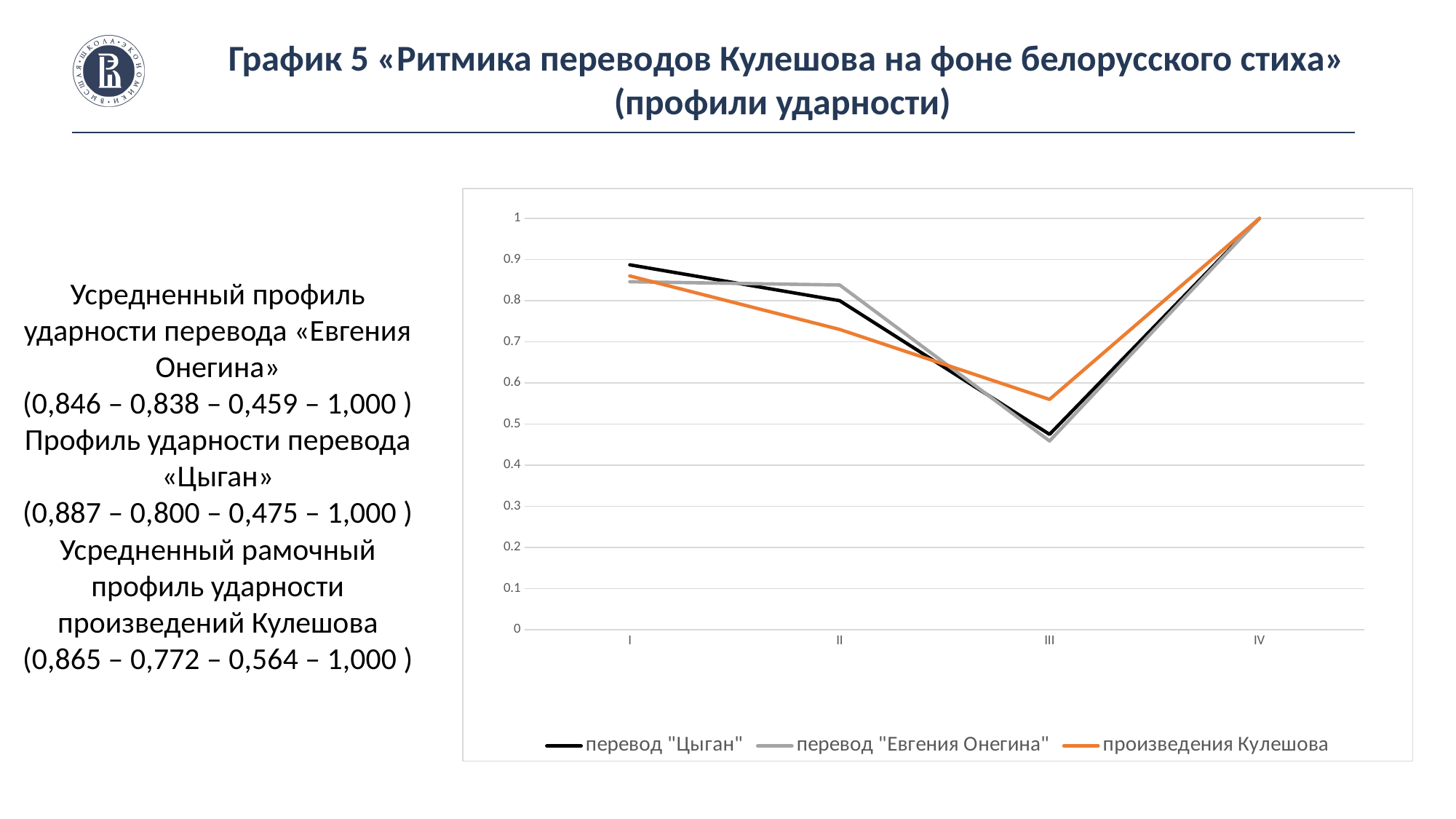
What kind of chart is shown on the slide? line chart What is the difference between перевод "Цыган" and перевод "Евгения Онегина" at position I? 0,041 At which position does перевод "Евгения Онегина" reach its lowest value? III At position III, which is higher: произведения Кулешова or перевод "Цыган"? произведения Кулешова What is the value for произведения Кулешова at position III? 0,564 Is the value for произведения Кулешова at position II greater or less than 0.8? less How many positions are plotted along the x axis of the chart? 4 Is the value for перевод "Цыган" at position III greater or less than 0.5? less What is the value for перевод "Евгения Онегина" at position IV? 1,000 How many series does the chart legend list? 3 What is the value for перевод "Цыган" at position I? 0,887 Do the values of all three series rise or fall from position III to position IV? rise